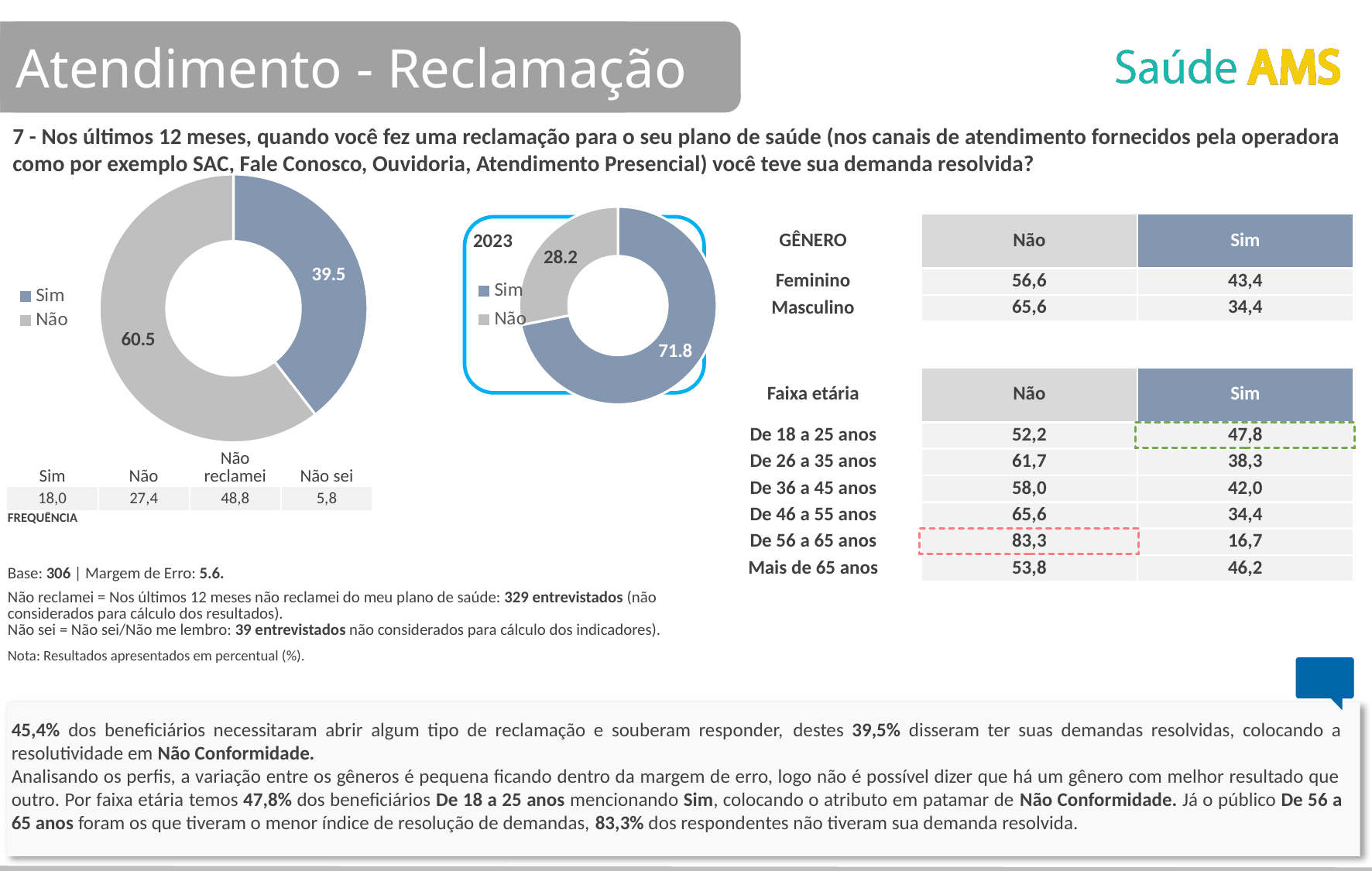
On the large donut chart on the left, what is the value for "Não"? 60.5 On the 2023 donut chart, what is the difference between the "Sim" and "Não" values? 43.6 On the 2023 donut chart, what is the value for "Sim"? 71.8 On the 2023 donut chart, what is the value for "Não"? 28.2 What type of chart is the large chart on the left of the slide? Donut (pie) chart On the large donut chart on the left, what is the difference between the "Não" and "Sim" values? 21.0 On the large donut chart on the left, which category has the larger share, "Sim" or "Não"? Não On the large donut chart on the left, what is the value for "Sim"? 39.5 How many categories does the legend of the large donut chart on the left list? 2 On the large donut chart on the left, which colour represents "Sim"? Blue Which year is labelled on the smaller donut chart in the middle of the slide? 2023 On the 2023 donut chart, which category is the largest? Sim